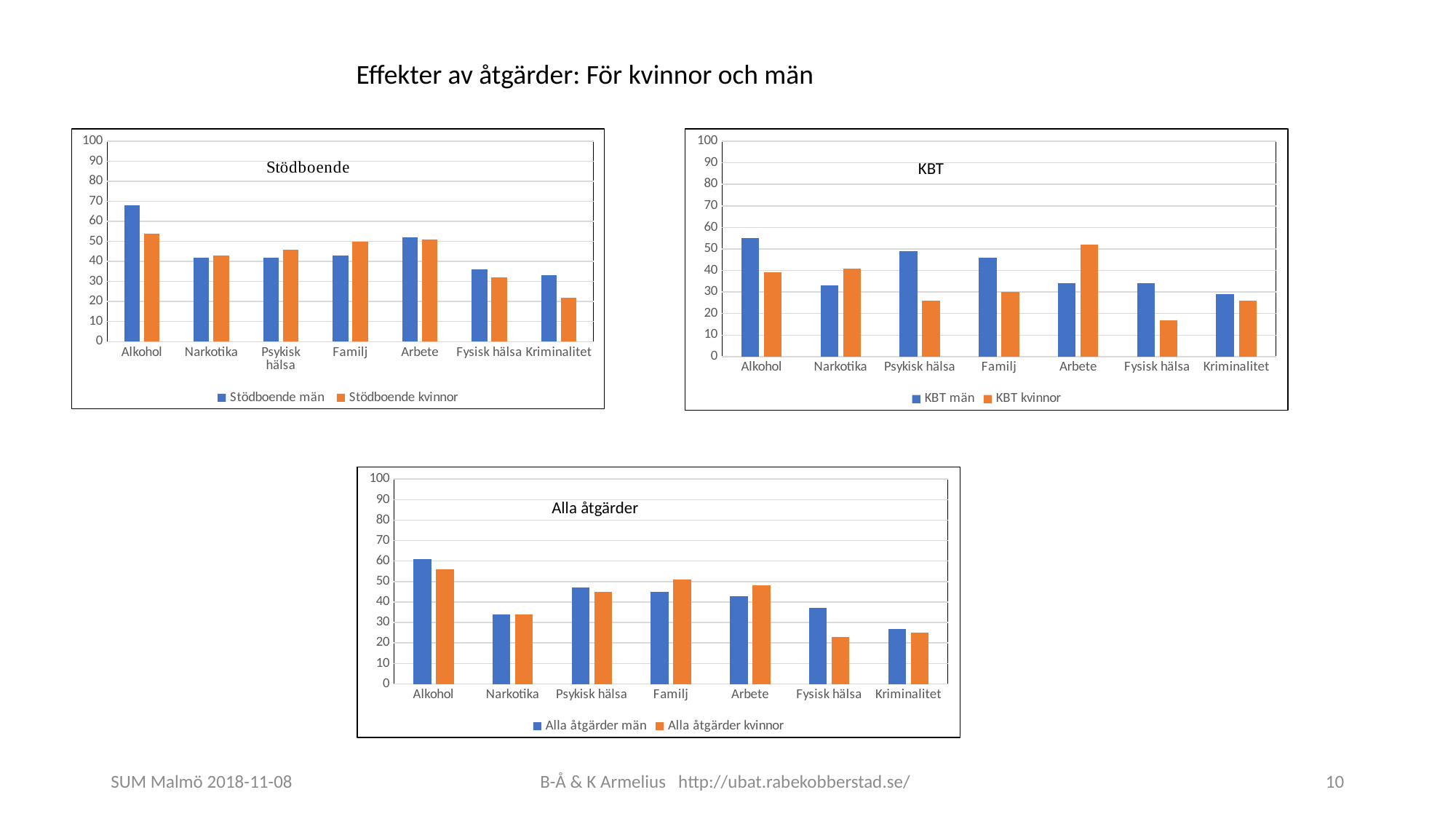
In the KBT chart, for Arbete, which is larger: KBT män or KBT kvinnor? KBT kvinnor How many categories are shown on the x axis of the KBT chart? 7 In the Stödboende chart, is the value for Stödboende män at Alkohol greater or less than 60? greater How many series does the legend of the Stödboende chart list? 2 In the Alla åtgärder chart, which category has the highest value for Alla åtgärder män? Alkohol In the Stödboende chart, which category has the highest value for Stödboende män? Alkohol In the KBT chart, is the value for KBT kvinnor at Fysisk hälsa greater or less than 20? less In the Stödboende chart, which category has the lowest value for Stödboende kvinnor? Kriminalitet In the Alla åtgärder chart, is the value for Alla åtgärder kvinnor at Fysisk hälsa greater or less than 30? less In the KBT chart, which category has the lowest value for KBT kvinnor? Fysisk hälsa What kind of chart is the Alla åtgärder chart? bar chart In the Alla åtgärder chart, for Familj, which is larger: Alla åtgärder män or Alla åtgärder kvinnor? Alla åtgärder kvinnor